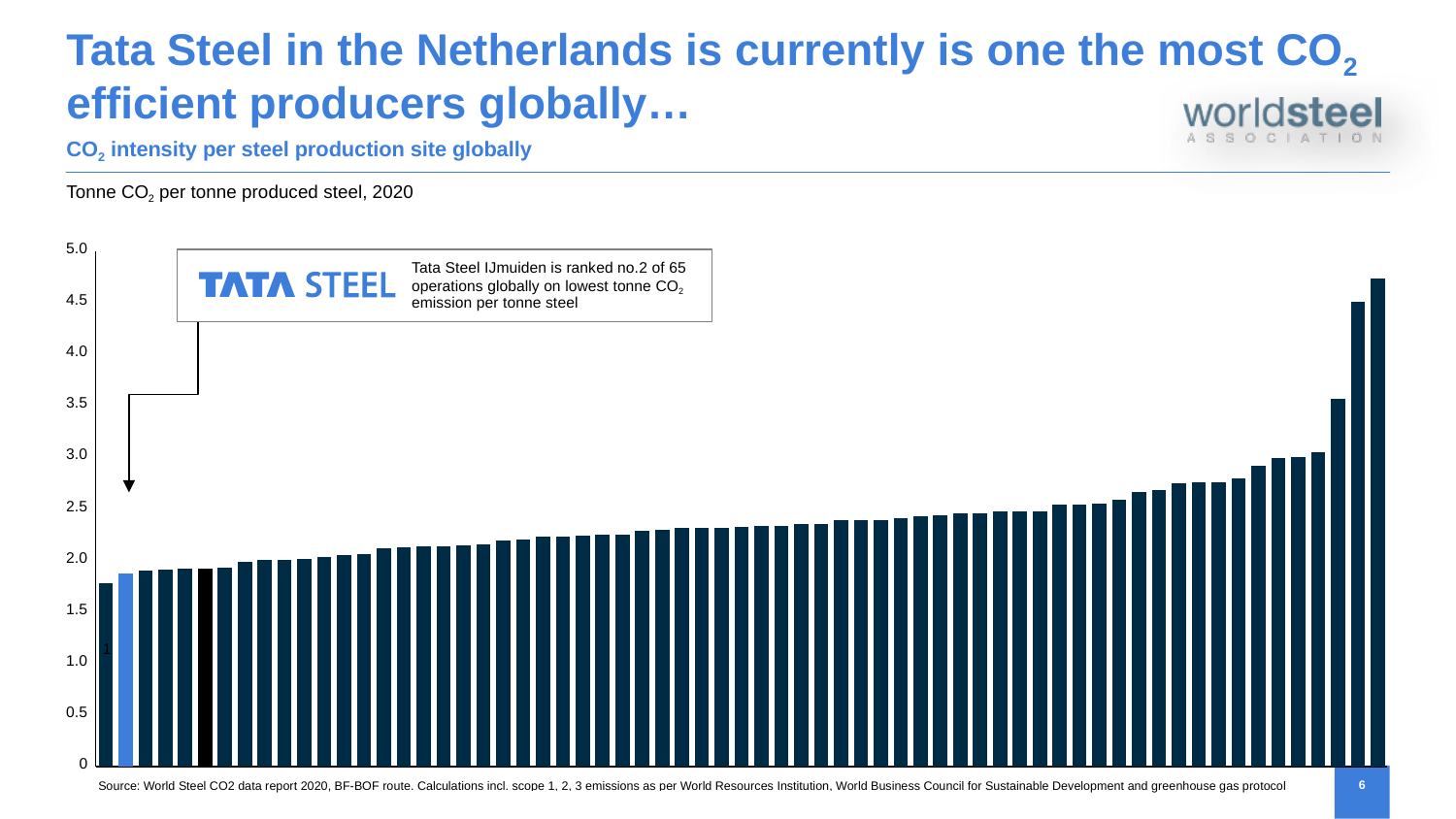
According to the slide, how many operations globally are ranked in the chart? 65 Is the value of the leftmost bar greater or less than 2.0? less Which bar is the highest: the leftmost bar or the rightmost bar? the rightmost bar Is the value of the highlighted light-blue bar greater or less than 1.5? greater Do the bar values rise or fall from left to right along the x axis? rise What kind of chart is shown on the slide? Bar chart Is the value of the tallest bar on the far right greater or less than 4.5? greater What is the highest value shown on the vertical axis? 5.0 What is the unit shown for the values on the chart? Tonne CO2 per tonne produced steel What rank does Tata Steel IJmuiden hold among the operations on lowest tonne CO2 emission per tonne steel? no.2